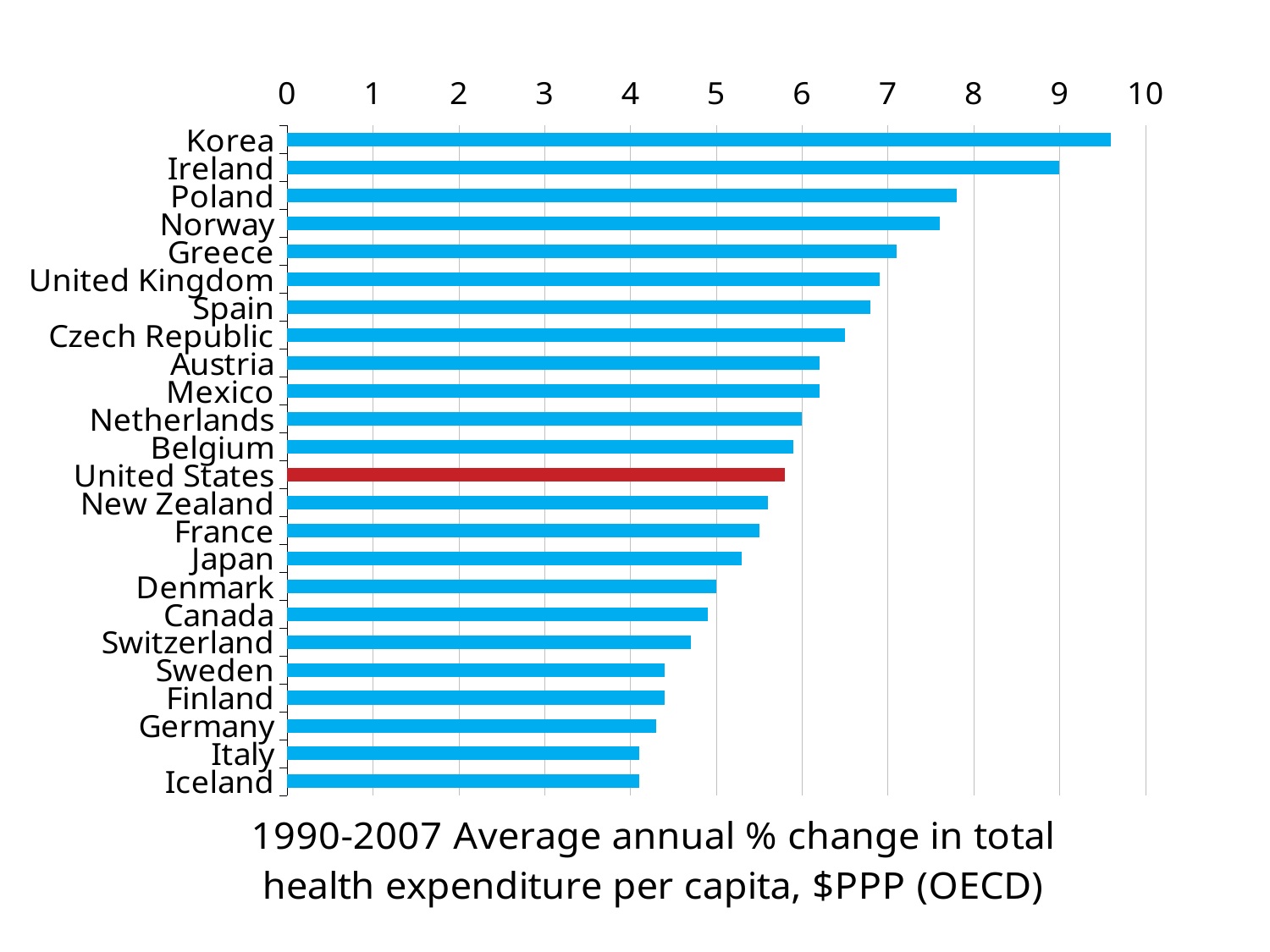
Which has a larger value, Canada or Spain? Spain Is the value for the United States greater or less than 6? less Which country has the highest average annual % change in total health expenditure per capita? Korea Is the value for Germany greater or less than 5? less How many countries are shown in the chart? 24 Is the value for Korea greater or less than 9? greater What kind of chart is shown on the slide? bar chart Which country's bar is shown in red rather than blue? United States Which has a larger value, Ireland or Norway? Ireland What period does the chart title say the average annual % change covers? 1990-2007